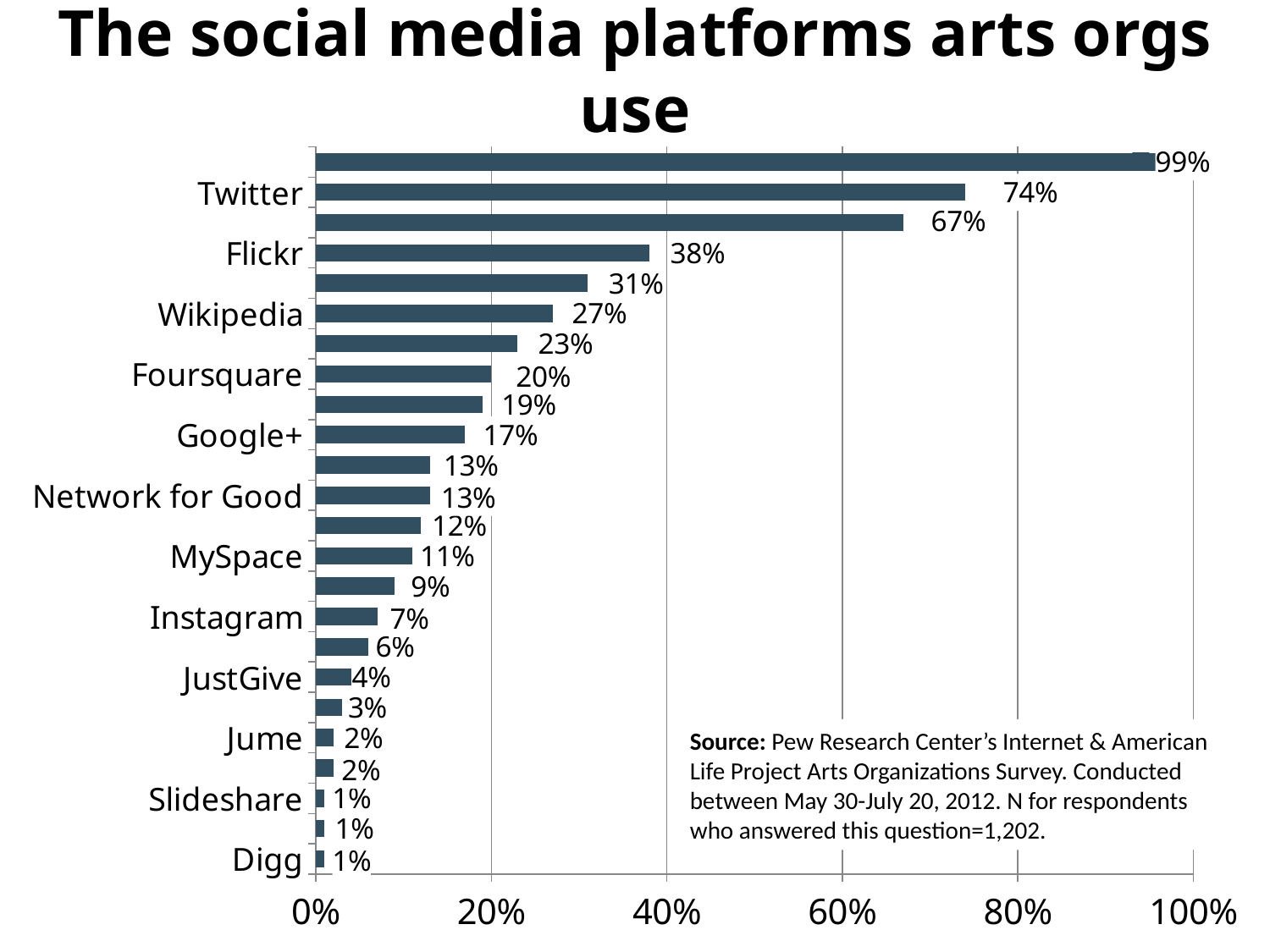
What percentage of arts organizations use Twitter? 74% What is the value shown for Flickr? 38% What is the highest value shown on the chart? 99% What is the value shown for Network for Good? 13% What is the value shown for Digg? 1% What percentage of arts organizations use Instagram? 7% What percentage is shown for Wikipedia? 27% What kind of chart is shown on the slide? Bar chart What is the value for Foursquare? 20% What is the difference between the values for Twitter and Flickr? 36 percentage points Which has a higher value, Google+ or MySpace? Google+ What is the title of the chart? The social media platforms arts orgs use